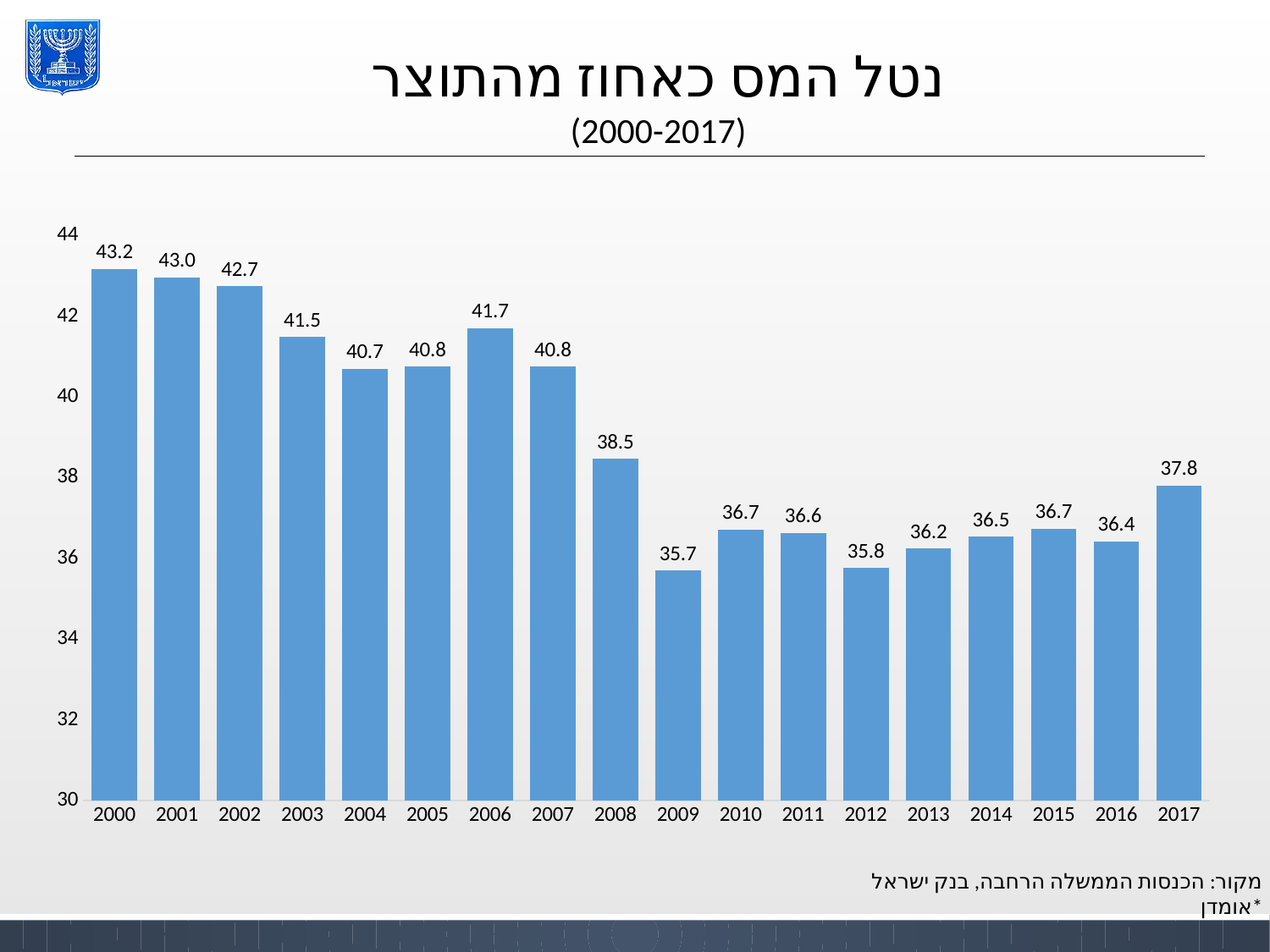
What is the value for 2017? 37.8 What is the difference between the values for 2007 and 2008? 2.3 Do the values generally rise or fall from 2000 to 2009? fall Is the value for 2008 greater or less than 38? greater How many years are shown on the x axis? 18 What is the difference between the values for 2000 and 2017? 5.4 Which year has the highest value? 2000 Which year has the lowest value? 2009 What is the value for 2000? 43.2 Which is larger, the value for 2006 or the value for 2003? 2006 What kind of chart is shown on the slide? bar chart What is the value for 2009? 35.7